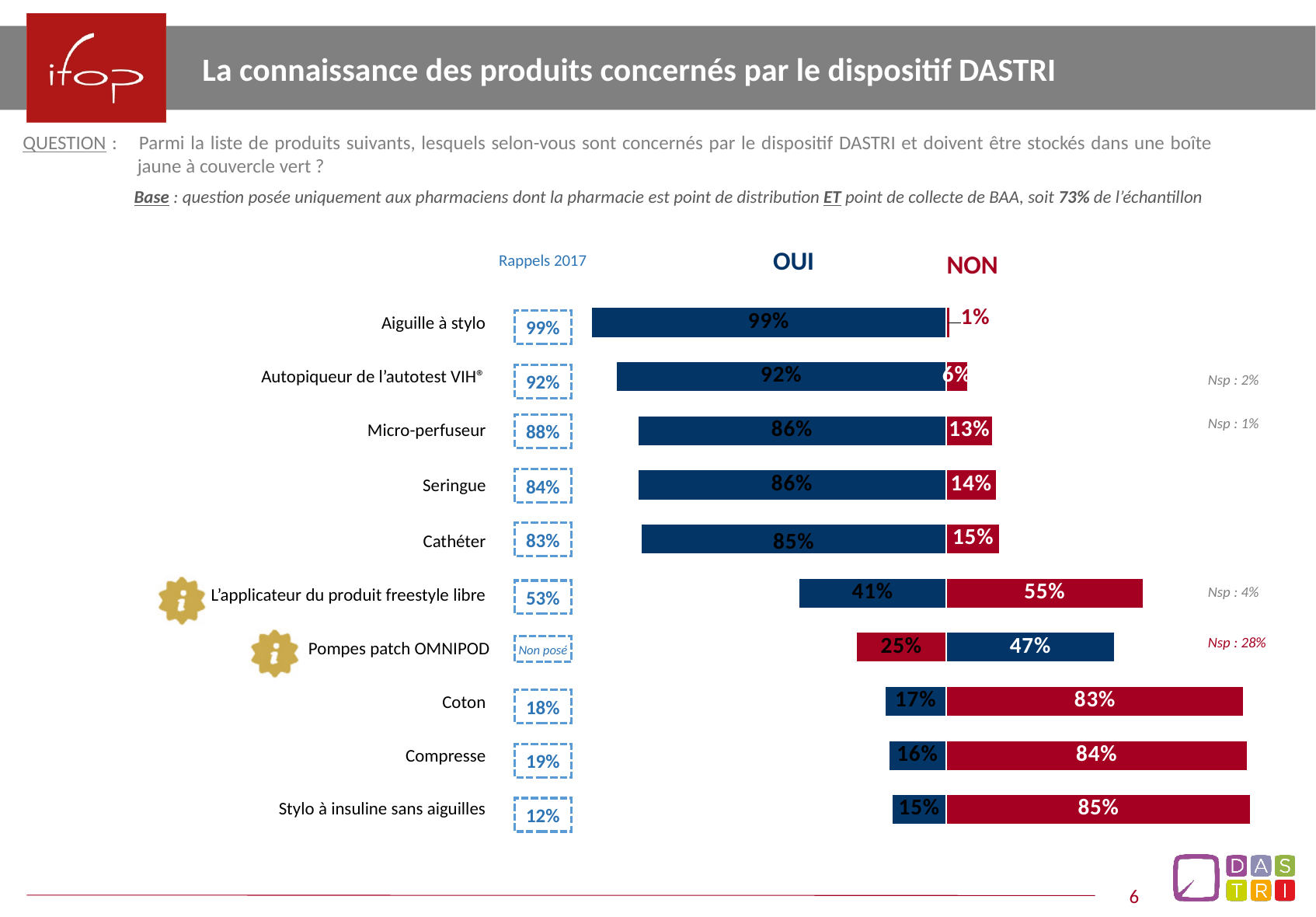
What kind of chart is shown on the slide? Bar chart Which product has the highest OUI value? Aiguille à stylo Which product has the highest NON value? Stylo à insuline sans aiguilles Which product has the lowest NON value? Aiguille à stylo What is the NON value for Coton? 83% What is the Rappels 2017 value for Micro-perfuseur? 88% Which is larger for Cathéter: the OUI value or the NON value? OUI What is the OUI value for L'applicateur du produit freestyle libre? 41% How many products are listed in the chart? 10 What is the OUI value for Aiguille à stylo? 99% What is the difference between the NON values for Compresse and Coton? 1% What is the Nsp value noted for Pompes patch OMNIPOD? 28%